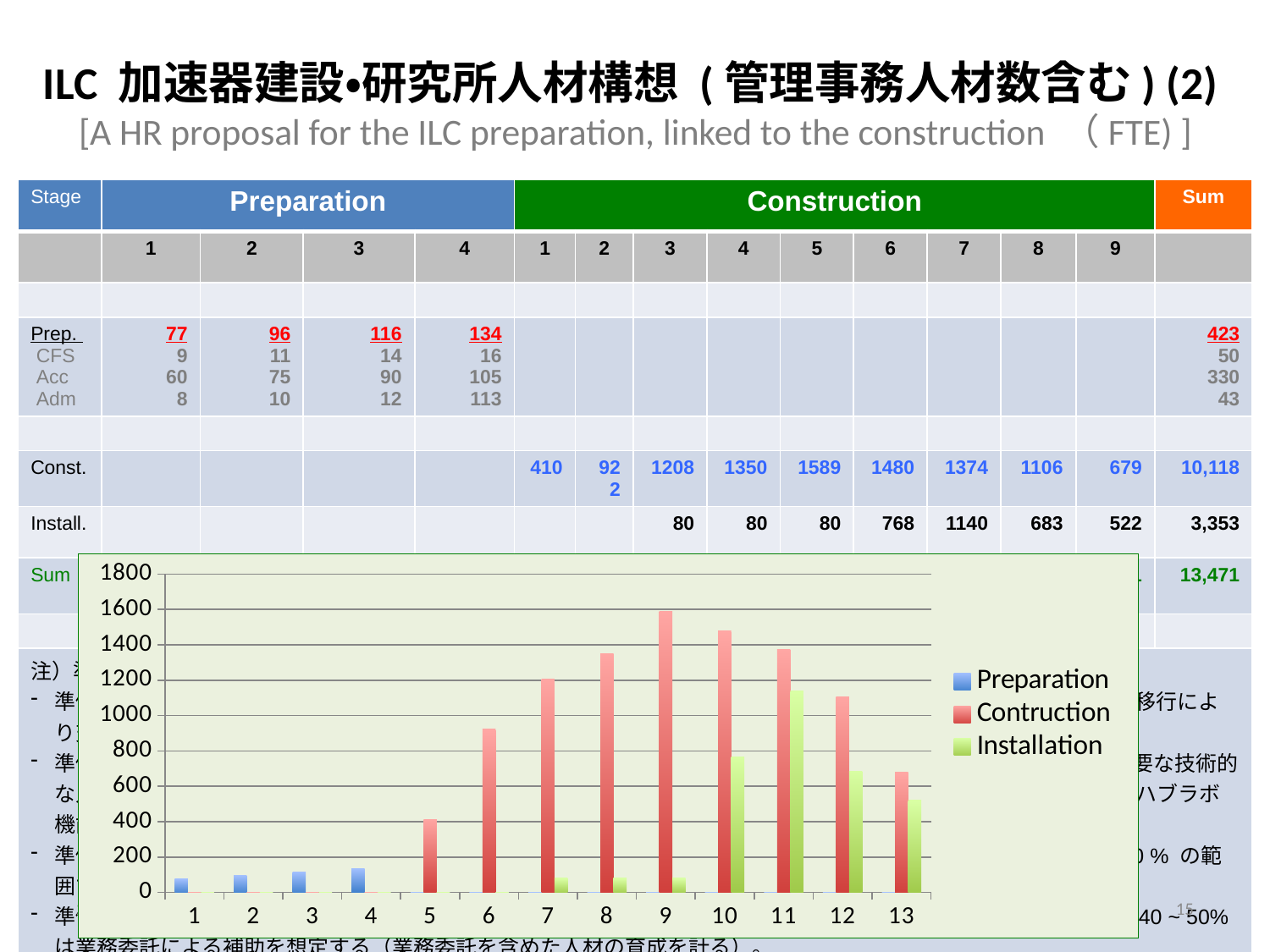
Which is larger: the Contruction value at category 7 or at category 13? category 7 How many categories are shown along the x axis of the chart? 13 Is the Contruction value at category 5 greater or less than 600? less How many series does the chart legend list? 3 At which x-axis category is the Contruction series highest? 9 Do the Preparation values rise or fall from category 1 to category 4? rise Do the Contruction values rise or fall from category 9 to category 13? fall What kind of chart is shown on the slide? bar chart What colour represents the Installation series in the chart? green Is the Contruction value at category 9 greater or less than 1400? greater Is the Installation value at category 11 greater or less than 1000? greater At which x-axis category is the Installation series highest? 11